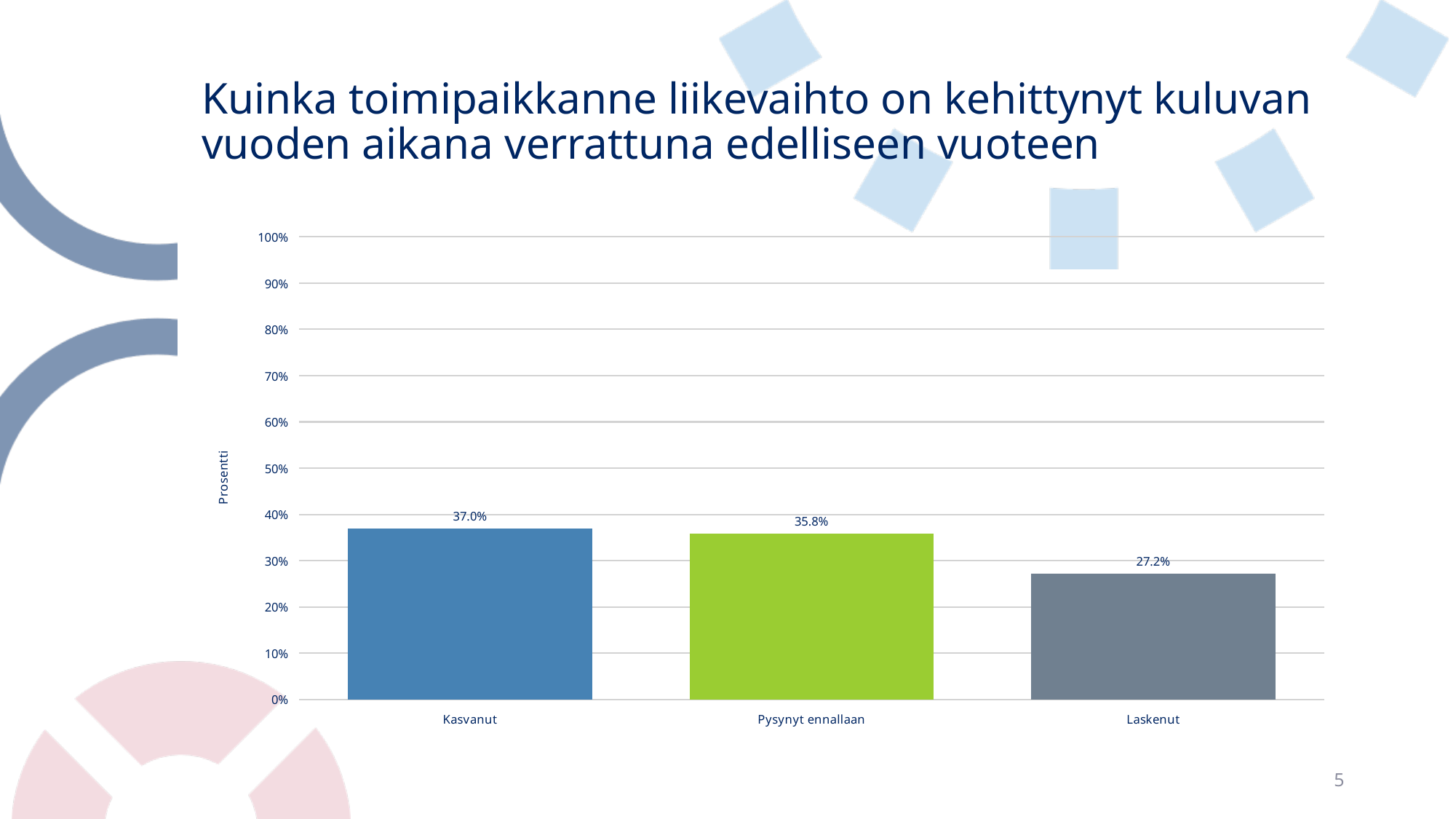
What is the difference between the values for Kasvanut and Laskenut? 9.8% Which category has the lowest value? Laskenut Which is larger, the value for Pysynyt ennallaan or the value for Laskenut? Pysynyt ennallaan Which category has the highest value? Kasvanut What is the label of the vertical axis? Prosentti What is the value for Pysynyt ennallaan? 35.8% What is the value for Kasvanut? 37.0% What is the difference between the values for Pysynyt ennallaan and Laskenut? 8.6% What is the value for Laskenut? 27.2% Is the value for Laskenut greater or less than 30%? less What kind of chart is shown on the slide? bar chart How many categories are shown on the x axis? 3